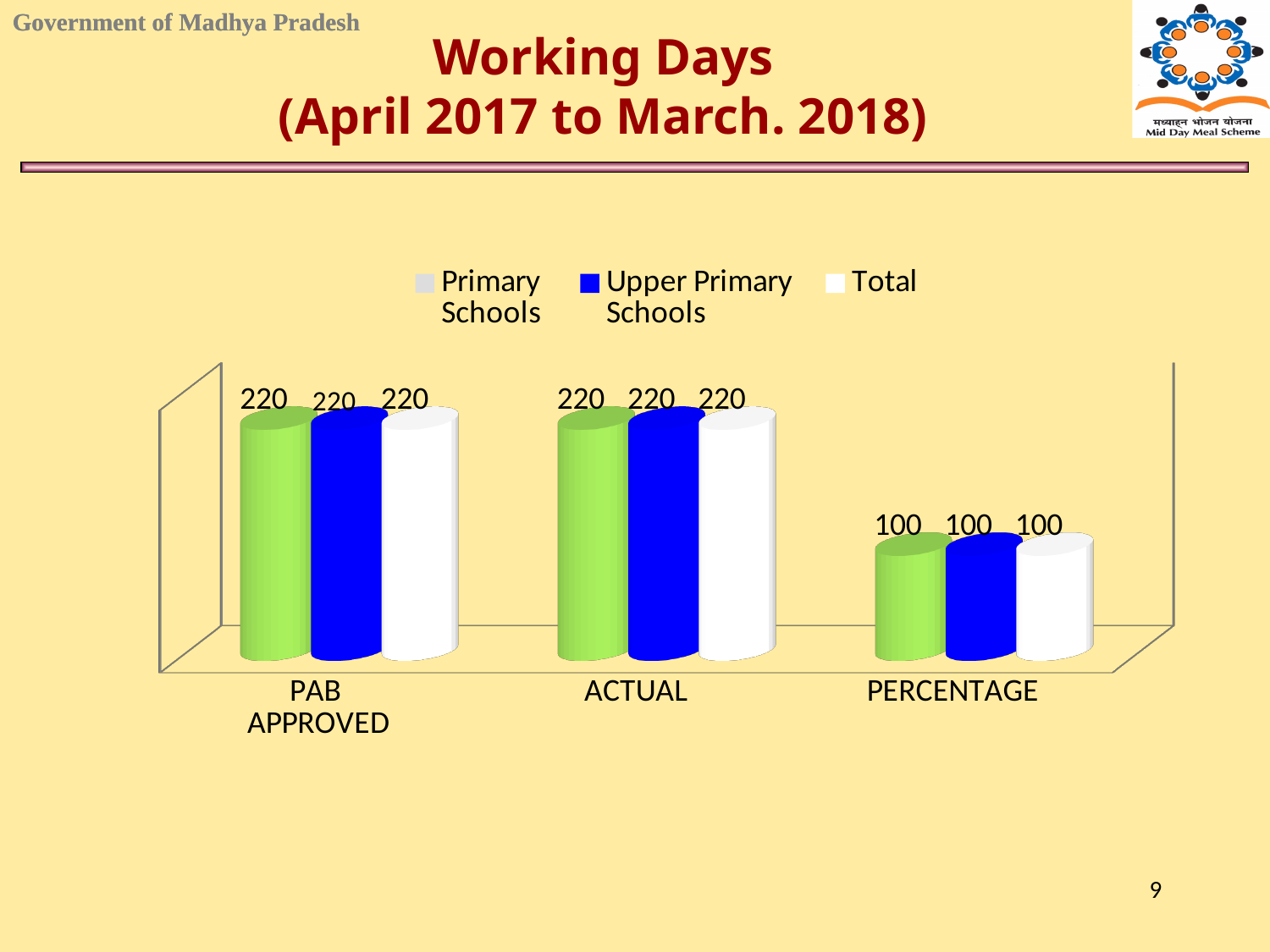
What is the value for Total in the PERCENTAGE category? 100 How many categories are shown on the x axis? 3 Which series is shown in blue in the legend? Upper Primary Schools What is the value for Primary Schools in the PAB APPROVED category? 220 Which category has the lowest values across all series? PERCENTAGE Which is larger: the Primary Schools value for ACTUAL or the Primary Schools value for PERCENTAGE? ACTUAL What is the difference between the Total value for PAB APPROVED and the Total value for PERCENTAGE? 120 What is the value for Upper Primary Schools in the PERCENTAGE category? 100 How many series does the legend list? 3 What is the title of the slide containing the chart? Working Days (April 2017 to March. 2018) What is the value for Upper Primary Schools in the ACTUAL category? 220 What kind of chart is shown on the slide? Bar chart